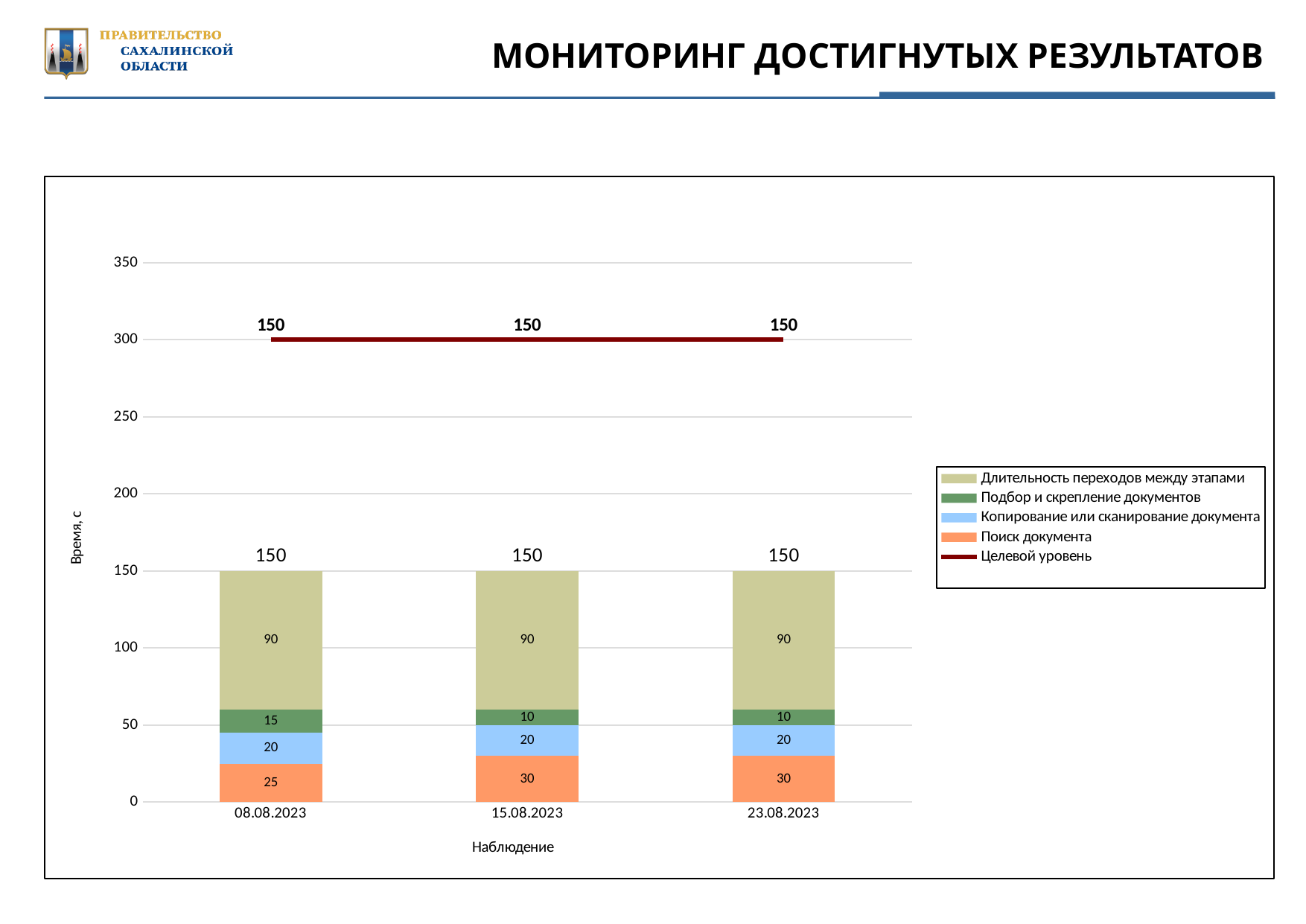
What is the label of the y axis? Время, с What is the difference between the "Поиск документа" values for 15.08.2023 and 08.08.2023? 5 What is the value of "Длительность переходов между этапами" for 23.08.2023? 90 What is the total of the stacked bar for 15.08.2023? 150 What is the value of "Подбор и скрепление документов" for 15.08.2023? 10 What kind of chart is shown on the slide? Stacked bar chart What is the labelled value of the "Целевой уровень" line at 15.08.2023? 150 What is the value of "Поиск документа" for 08.08.2023? 25 Which is larger: "Подбор и скрепление документов" for 08.08.2023 or for 23.08.2023? 08.08.2023 How many entries does the legend list? 5 How many observation dates are shown on the x axis? 3 What is the value of "Копирование или сканирование документа" for 23.08.2023? 20